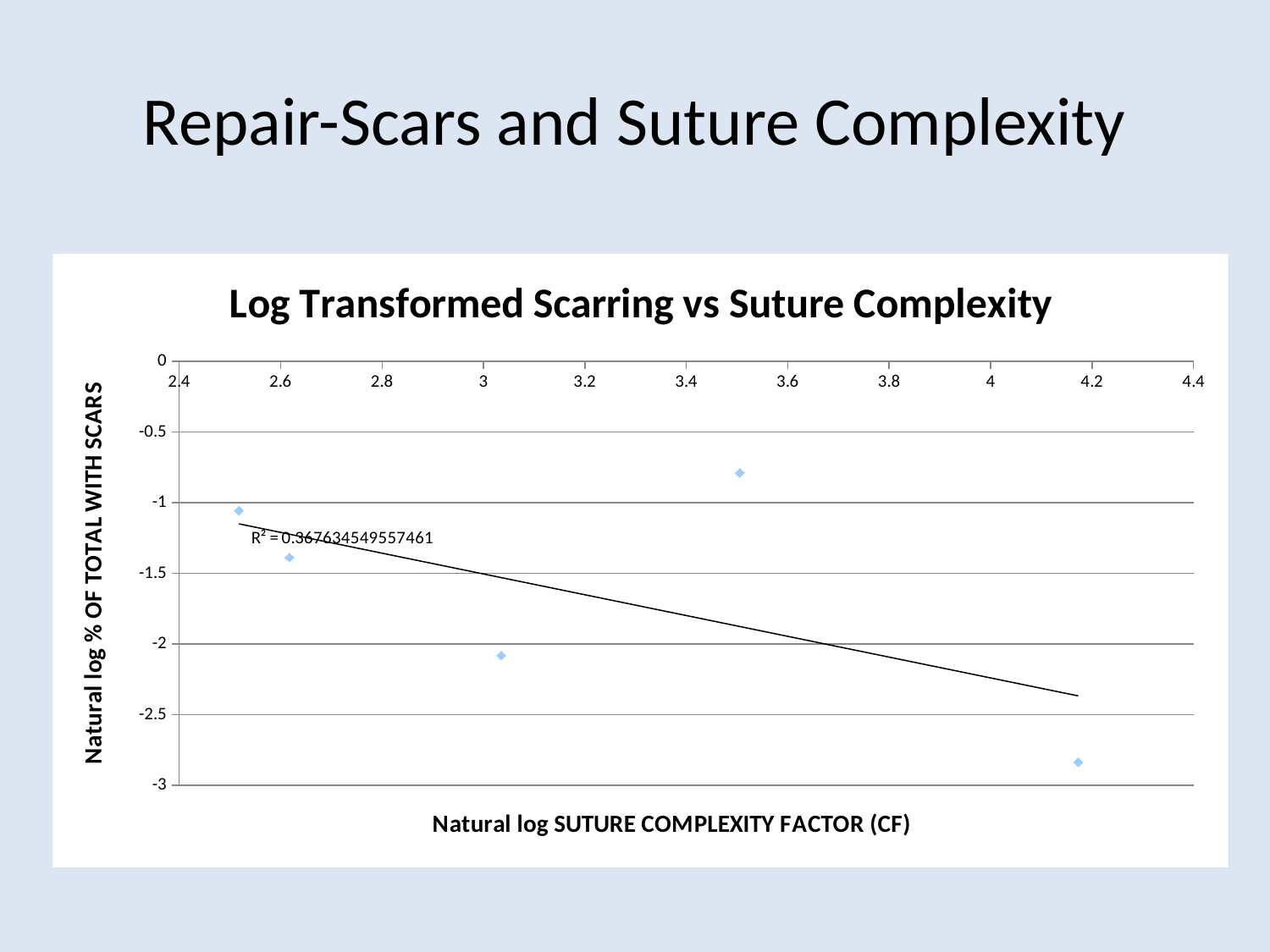
Is the y value of the leftmost data point (near x = 2.5) greater or less than -1.5? greater Which data point has the highest y value: the one near x = 3.5 or the one near x = 3? the one near x = 3.5 What kind of chart is shown on the slide? scatter chart What is the maximum value shown on the x axis? 4.4 Is the y value of the data point near x = 2.6 greater or less than -1? less Which data point has the lowest y value on the chart? the point with the largest x value (near 4.2) What is the title of the chart? Log Transformed Scarring vs Suture Complexity What is the R² value printed on the chart? 0.367634549557461 Does the trendline rise or fall as the natural log suture complexity factor increases? fall Is the y value of the data point near x = 3.5 greater or less than -1? greater How many data points are plotted in the chart? 5